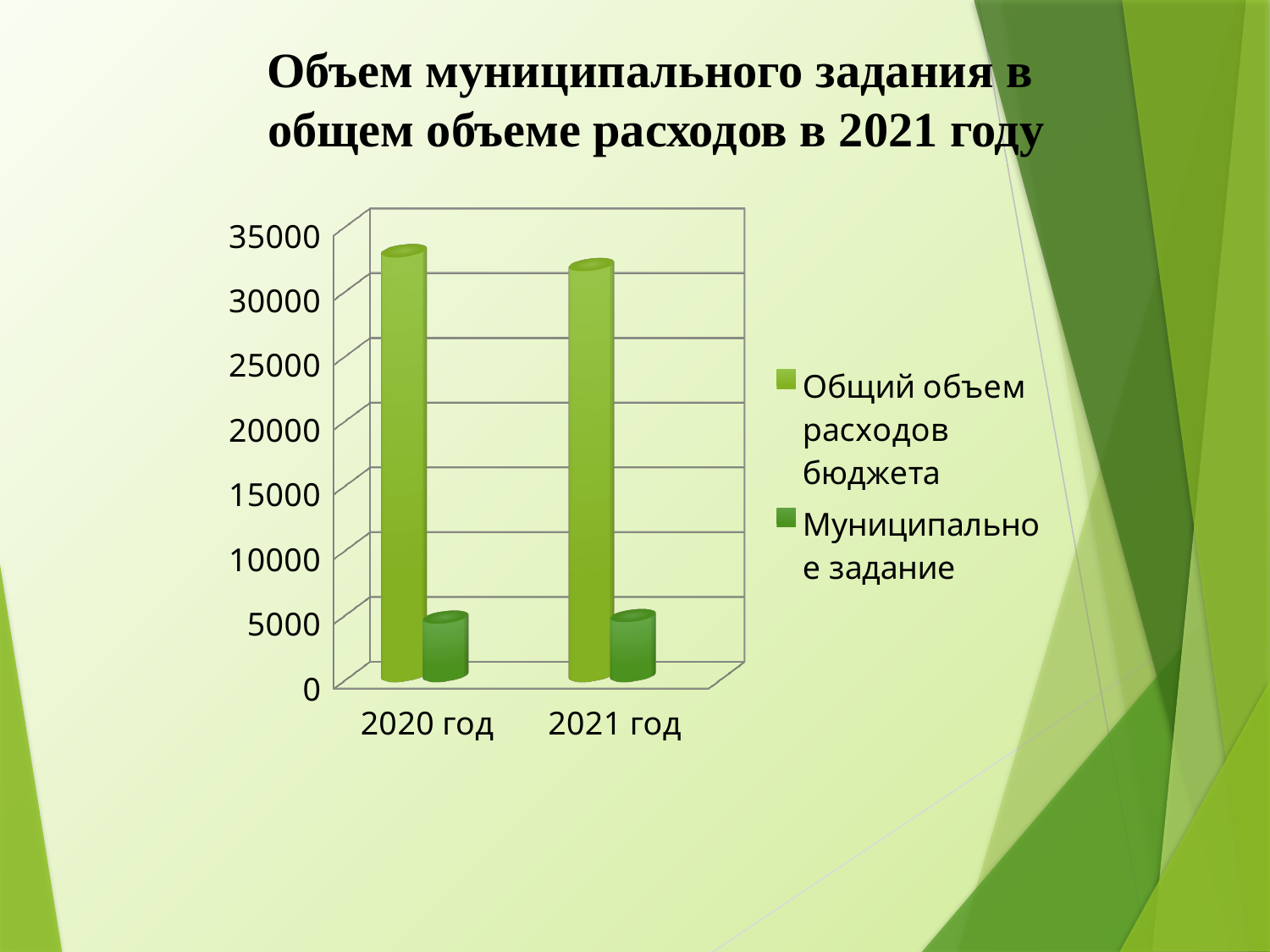
How many series does the legend list? 2 For Общий объем расходов бюджета, which year has the higher value: 2020 год or 2021 год? 2020 год How many categories are shown on the x axis? 2 What are the two categories on the x axis? 2020 год, 2021 год Is the value for Общий объем расходов бюджета in 2021 год greater or less than 30000? greater What kind of chart is shown on the slide? bar chart Does the value for Общий объем расходов бюджета rise or fall from 2020 год to 2021 год? fall What is the title of the chart? Объем муниципального задания в общем объеме расходов в 2021 году Is the value for Муниципальное задание in 2021 год greater or less than 10000? less Is the value for Муниципальное задание in 2020 год greater or less than 10000? less In 2021 год, which is larger: Общий объем расходов бюджета or Муниципальное задание? Общий объем расходов бюджета